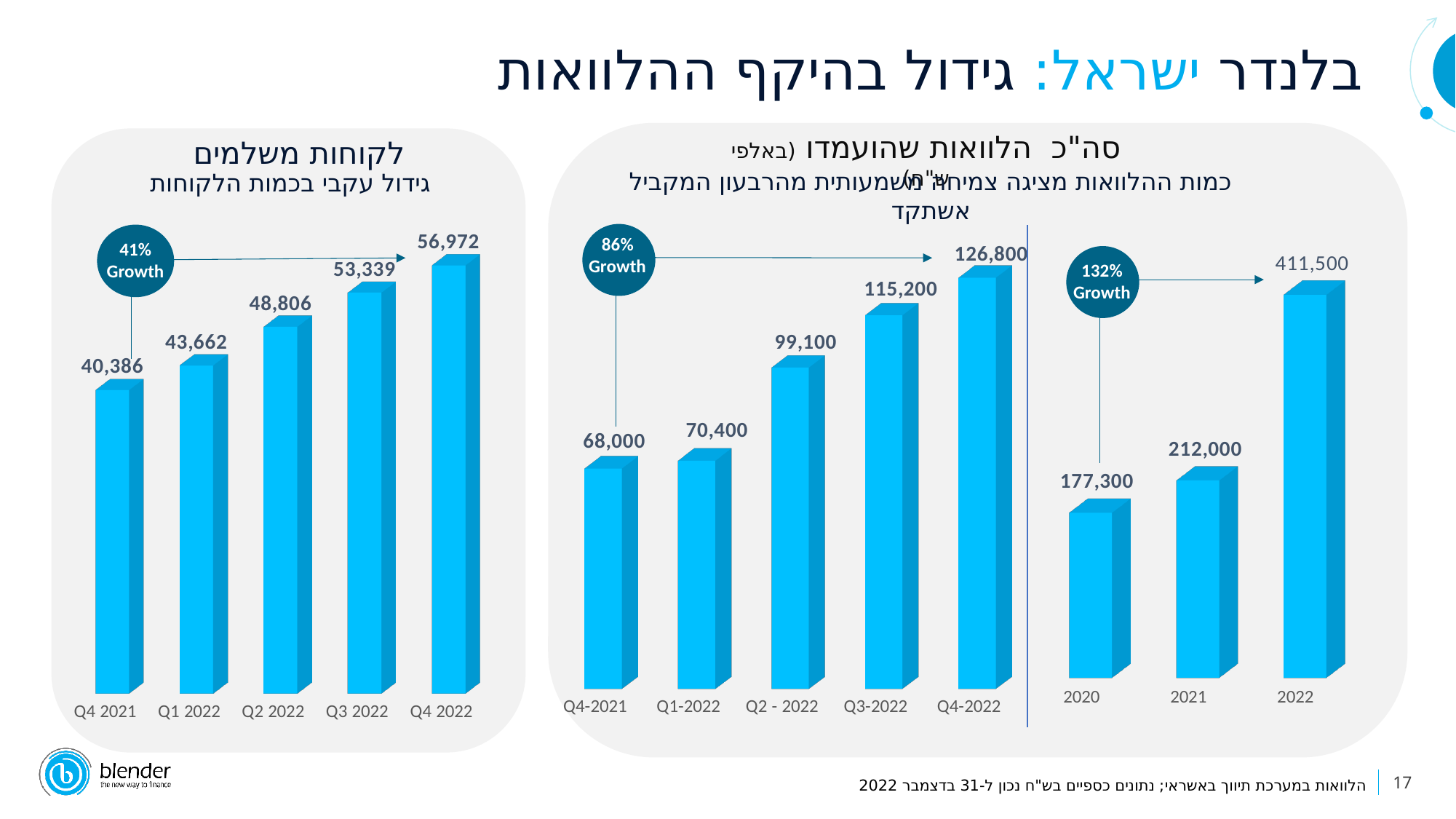
On the left chart (paying customers), what is the value for Q4 2021? 40,386 On the left chart (paying customers), what is the value for Q4 2022? 56,972 On the left chart (paying customers), do the values rise or fall from Q4 2021 to Q4 2022? rise On the left chart (paying customers), which quarter has the lowest value? Q4 2021 On the left chart (paying customers), how many quarters are shown? 5 What kind of chart is used on the left (paying customers)? bar chart On the right chart (annual loans), which is larger, 2020 or 2021? 2021 On the middle chart (quarterly loans), what is the difference between Q4-2022 and Q4-2021? 58,800 On the middle chart (quarterly loans), what is the value for Q2 - 2022? 99,100 On the left chart (paying customers), what is the difference between Q4 2022 and Q4 2021? 16,586 On the middle chart (quarterly loans), which quarter has the highest value? Q4-2022 On the right chart (annual loans), what is the value for 2022? 411,500